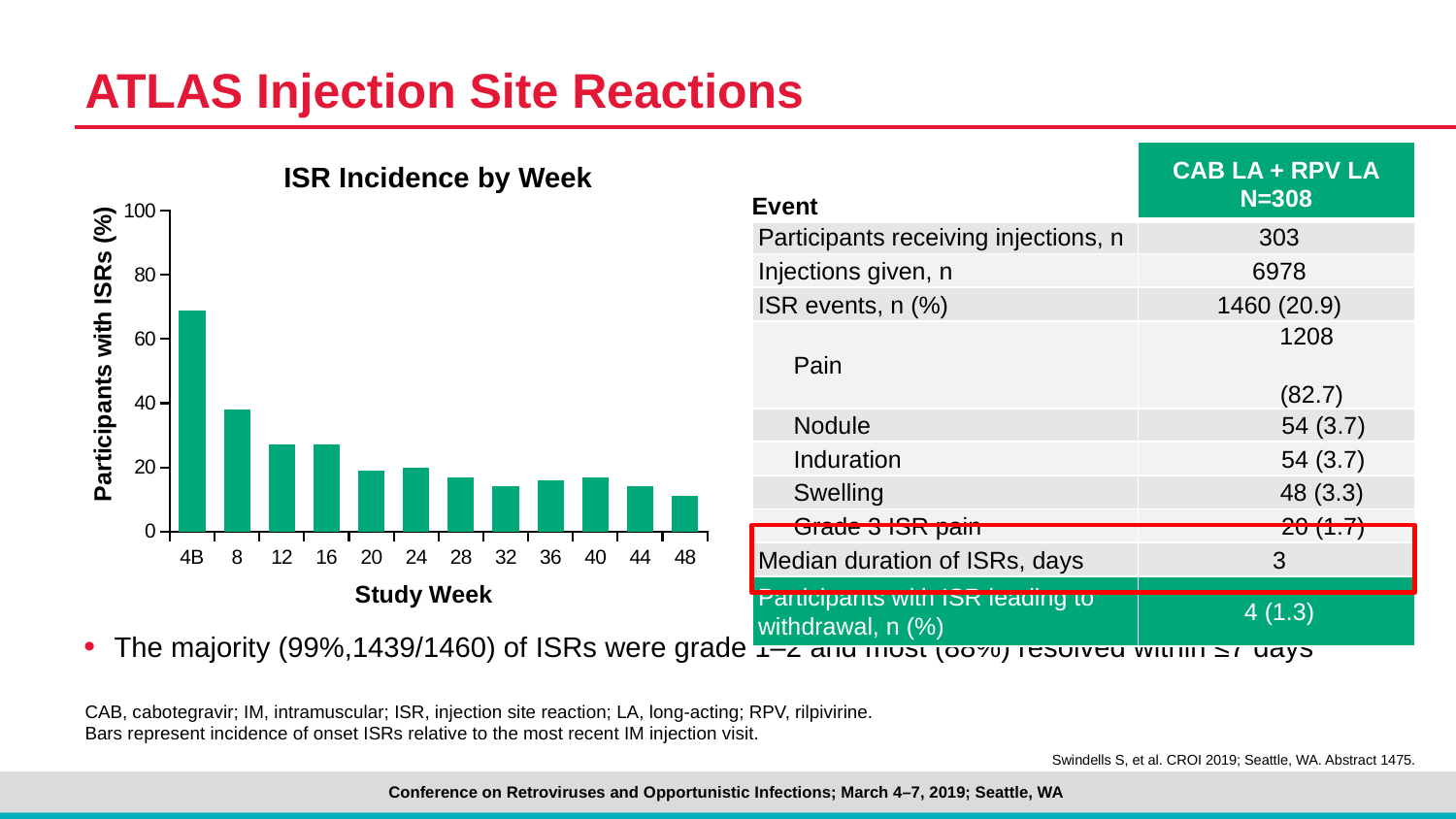
Which has a higher percentage of participants with ISRs, study week 4B or study week 8? 4B What kind of chart is shown on the slide? bar chart How many study weeks are plotted on the x axis of the chart? 12 Which study week has the highest percentage of participants with ISRs? 4B Is the value for study week 8 greater or less than 20? greater Do the values generally rise or fall as the study week increases? fall Is the value for study week 48 greater or less than 20? less Is the value for study week 32 greater or less than 20? less Which study week has the lowest percentage of participants with ISRs? 48 What is the title of the chart? ISR Incidence by Week What is the label of the y axis of the chart? Participants with ISRs (%)